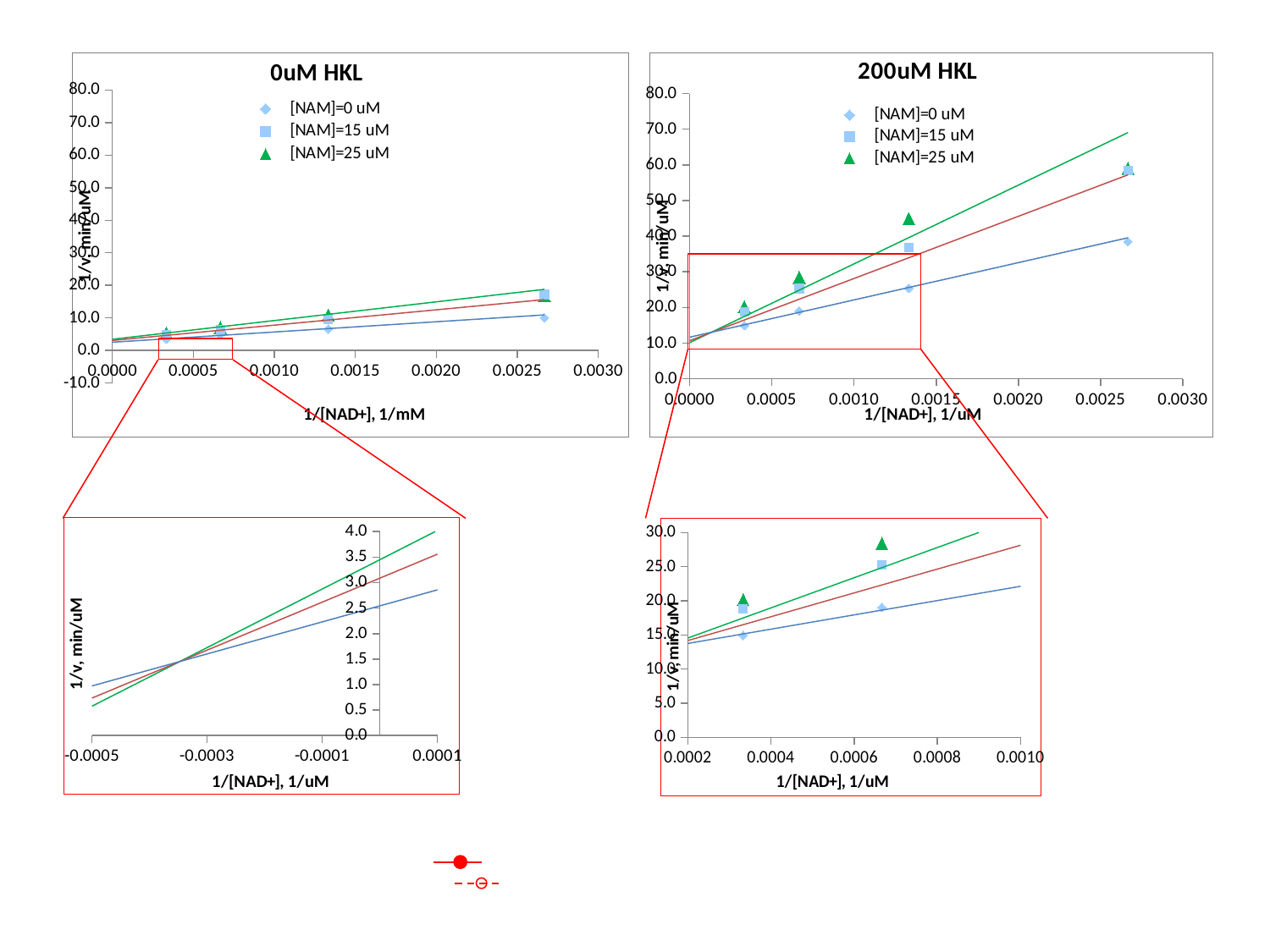
In the "200uM HKL" chart, is the value of the [NAM]=25 uM series at the largest 1/[NAD+] (about 0.0027) greater or less than 50? greater In the "200uM HKL" chart, which series has the lowest value at the largest 1/[NAD+] (about 0.0027)? [NAM]=0 uM What are the legend entries on the "0uM HKL" chart? [NAM]=0 uM, [NAM]=15 uM, [NAM]=25 uM How many data points are plotted for the [NAM]=0 uM series in the "200uM HKL" chart? 4 How many series does the legend of the "200uM HKL" chart list? 3 In the "200uM HKL" chart, is the value of the [NAM]=0 uM series at the largest 1/[NAD+] (about 0.0027) greater or less than 30? greater In the "0uM HKL" chart, is the value of the [NAM]=0 uM series at the largest 1/[NAD+] (about 0.0027) greater or less than 20? less What kind of chart is the "0uM HKL" chart? scatter chart In the "200uM HKL" chart, at 1/[NAD+] of about 0.0013, which series has the larger value: [NAM]=25 uM or [NAM]=0 uM? [NAM]=25 uM In the "0uM HKL" chart, do the values of the [NAM]=15 uM series rise or fall as 1/[NAD+] increases? rise In the "200uM HKL" chart, do the values of the [NAM]=25 uM series rise or fall as 1/[NAD+] increases? rise What is the title of the chart at the top right of the slide? 200uM HKL